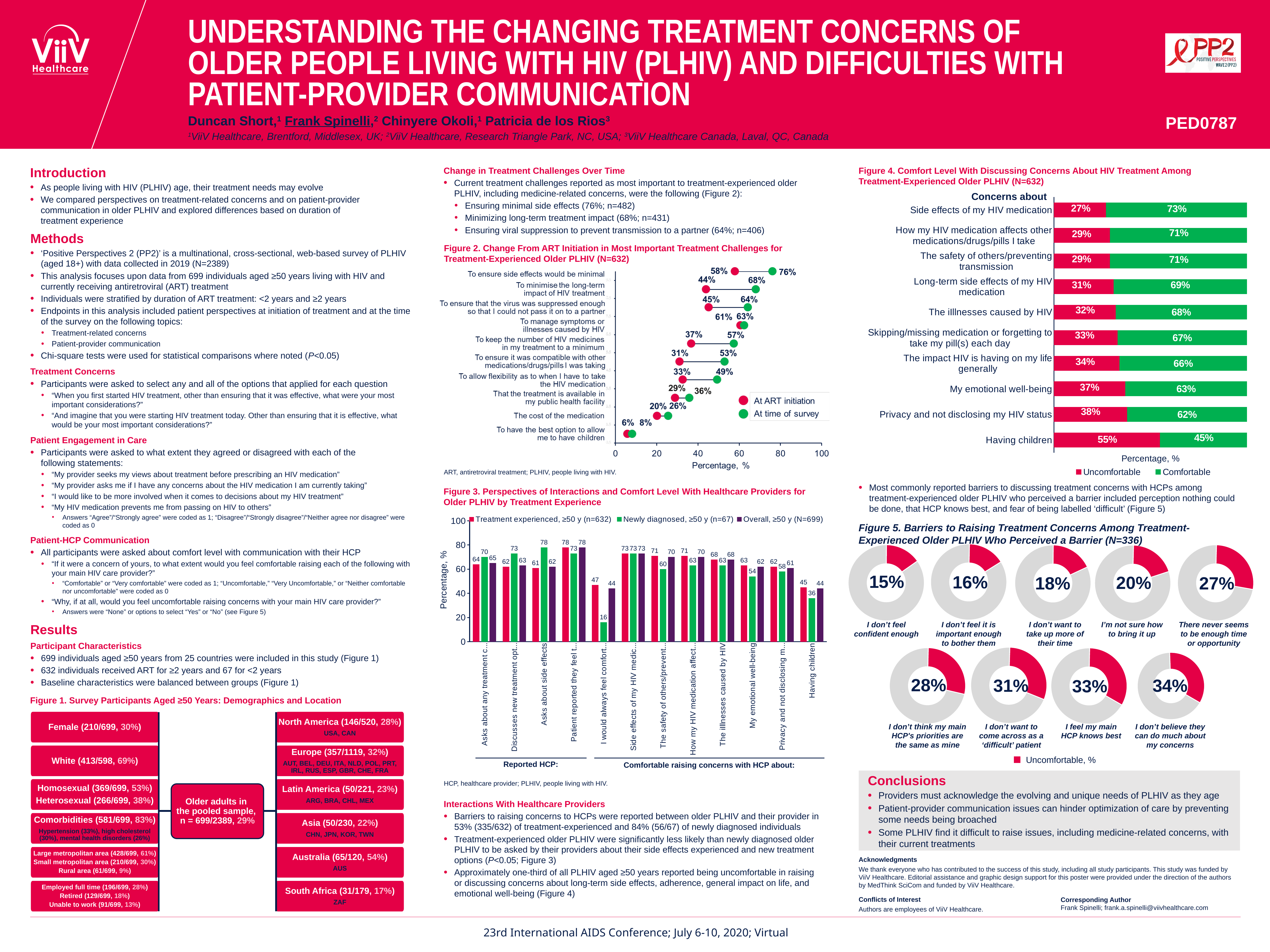
In Figure 2, which treatment challenge has the lowest value at ART initiation? To have the best option to allow me to have children In Figure 5, which barrier has the highest percentage? I don't believe they can do much about my concerns (34%) In Figure 4, what percentage of treatment-experienced older PLHIV were comfortable discussing side effects of their HIV medication? 73% In Figure 2, what percentage of treatment-experienced older PLHIV reported 'To ensure side effects would be minimal' at time of survey? 76% In Figure 3, what percentage of newly diagnosed older PLHIV reported that their HCP asks about side effects? 78 In Figure 4, which concern has the highest percentage of participants who were uncomfortable discussing it? Having children In Figure 2, what is the difference between the at-time-of-survey and at-ART-initiation values for 'To minimise the long-term impact of HIV treatment'? 24% In Figure 2, what was the value for 'The cost of the medication' at ART initiation? 20% How many concerns are listed in Figure 4? 10 What kind of chart is Figure 3? Bar chart In Figure 3, which is larger for 'I would always feel comfortable': the treatment-experienced value or the newly diagnosed value? Treatment experienced (47) How many series does the legend of Figure 2 list? 2